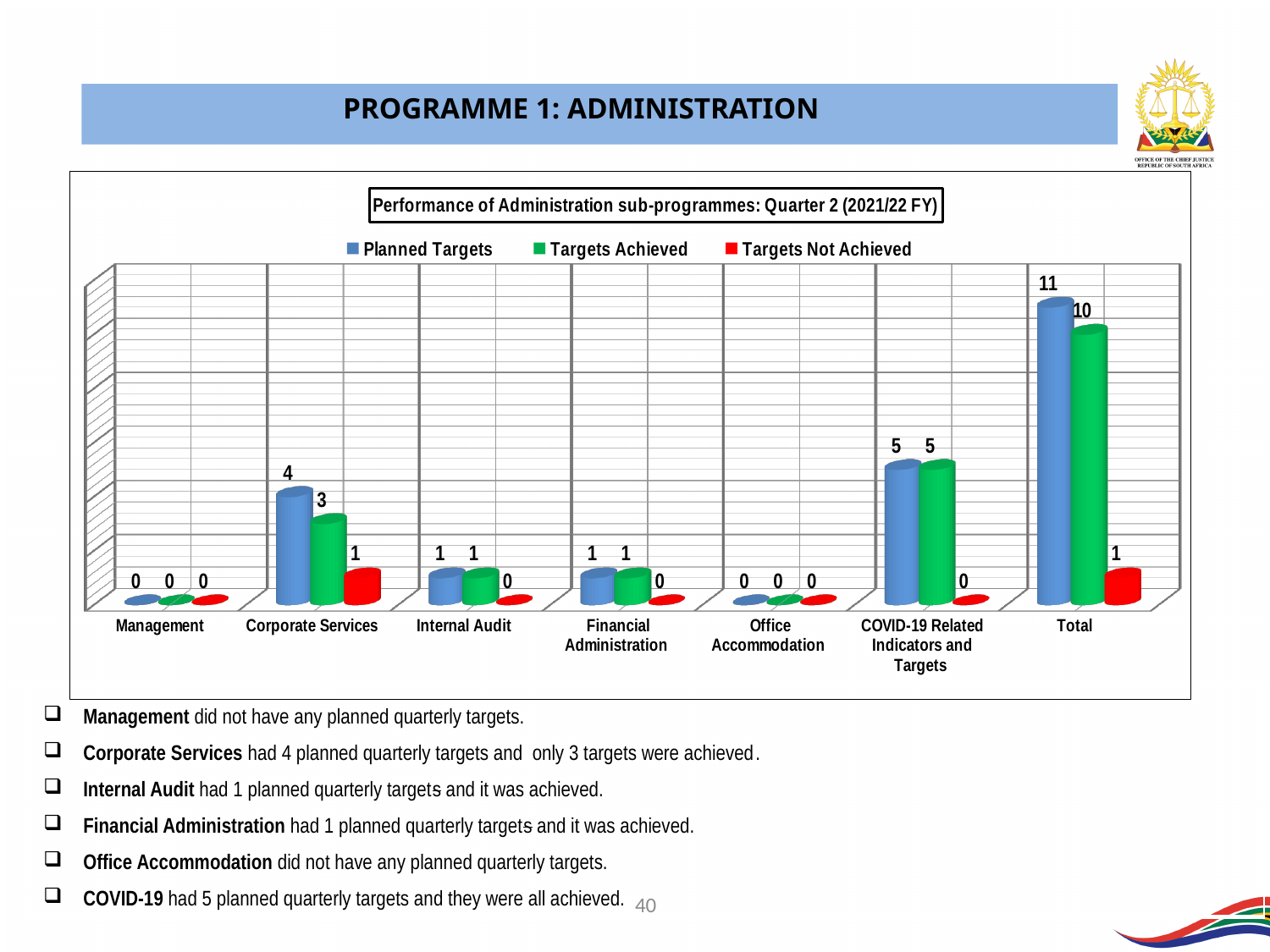
How many series does the legend list? 3 What is the title of the chart? Performance of Administration sub-programmes: Quarter 2 (2021/22 FY) What is the Targets Not Achieved value for Corporate Services? 1 What is the Planned Targets value for COVID-19 Related Indicators and Targets? 5 Which category has the highest Planned Targets value? Total Which is larger for Corporate Services: Planned Targets or Targets Achieved? Planned Targets What kind of chart is shown on the slide? Bar chart What is the Targets Achieved value for Total? 10 What is the difference between Planned Targets and Targets Achieved for Total? 1 What is the Planned Targets value for Corporate Services? 4 How many categories are shown on the x axis? 7 Excluding Total, which category has the highest Targets Achieved value? COVID-19 Related Indicators and Targets